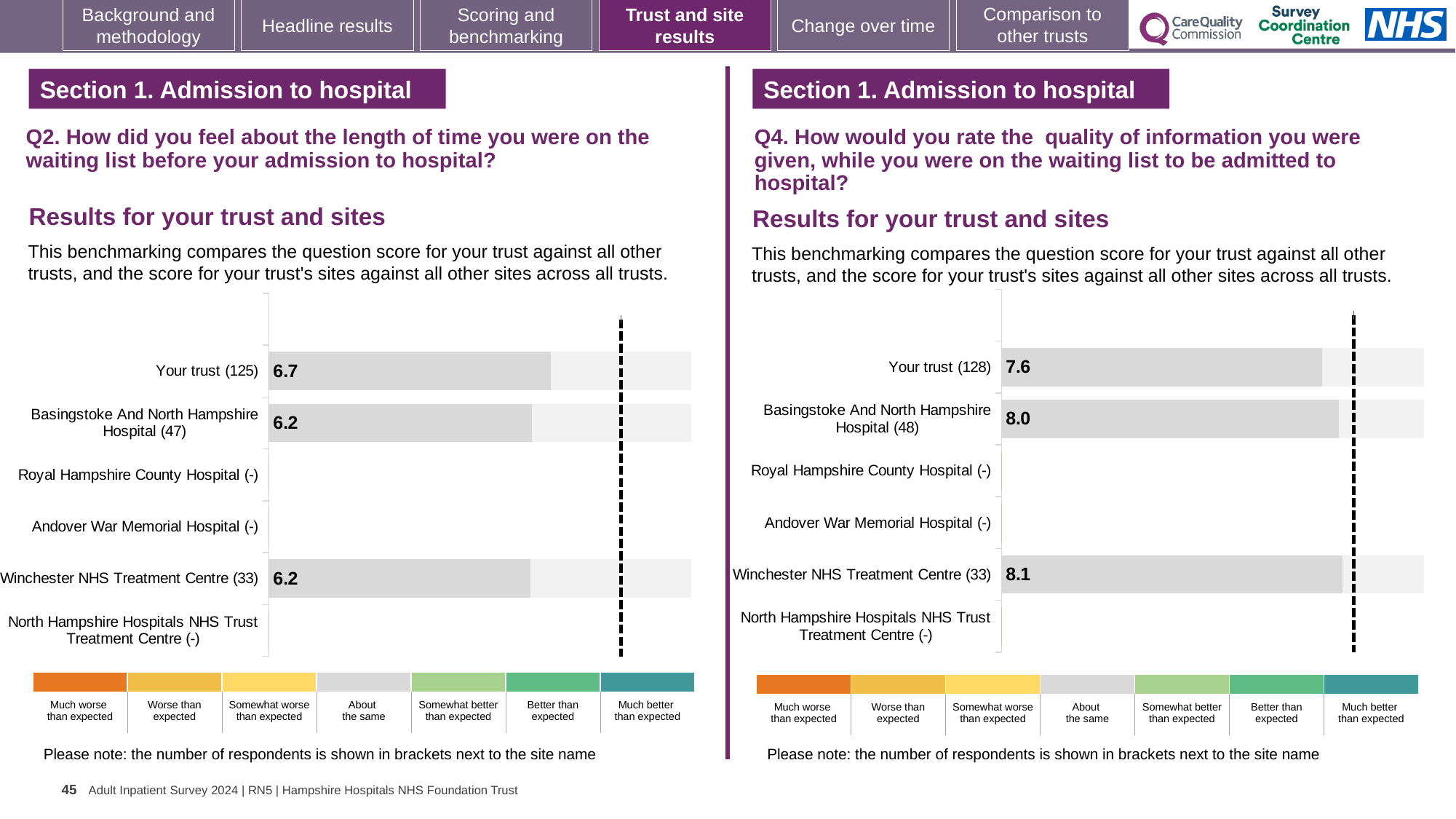
On the left chart (Q2), what is the difference between the score for Your trust and the score for Basingstoke And North Hampshire Hospital? 0.5 What kind of chart is used on the left (Q2) to show the results for your trust and sites? Bar chart On the right chart (Q4, quality of information while on the waiting list), what is the score for Your trust? 7.6 On the right chart (Q4), what is the difference between the score for Winchester NHS Treatment Centre and the score for Your trust? 0.5 On the right chart (Q4), what is the score for Basingstoke And North Hampshire Hospital? 8.0 On the left chart (Q2, length of time on the waiting list), what is the score for Your trust? 6.7 On the left chart (Q2), what is the score for Basingstoke And North Hampshire Hospital? 6.2 On the right chart (Q4), which site or trust has the highest score? Winchester NHS Treatment Centre On the right chart (Q4), which is larger: the score for Your trust or the score for Basingstoke And North Hampshire Hospital? Basingstoke And North Hampshire Hospital On the left chart (Q2), what is the score for Winchester NHS Treatment Centre? 6.2 On the right chart (Q4), what is the score for Winchester NHS Treatment Centre? 8.1 On the left chart (Q2), which has the highest score? Your trust